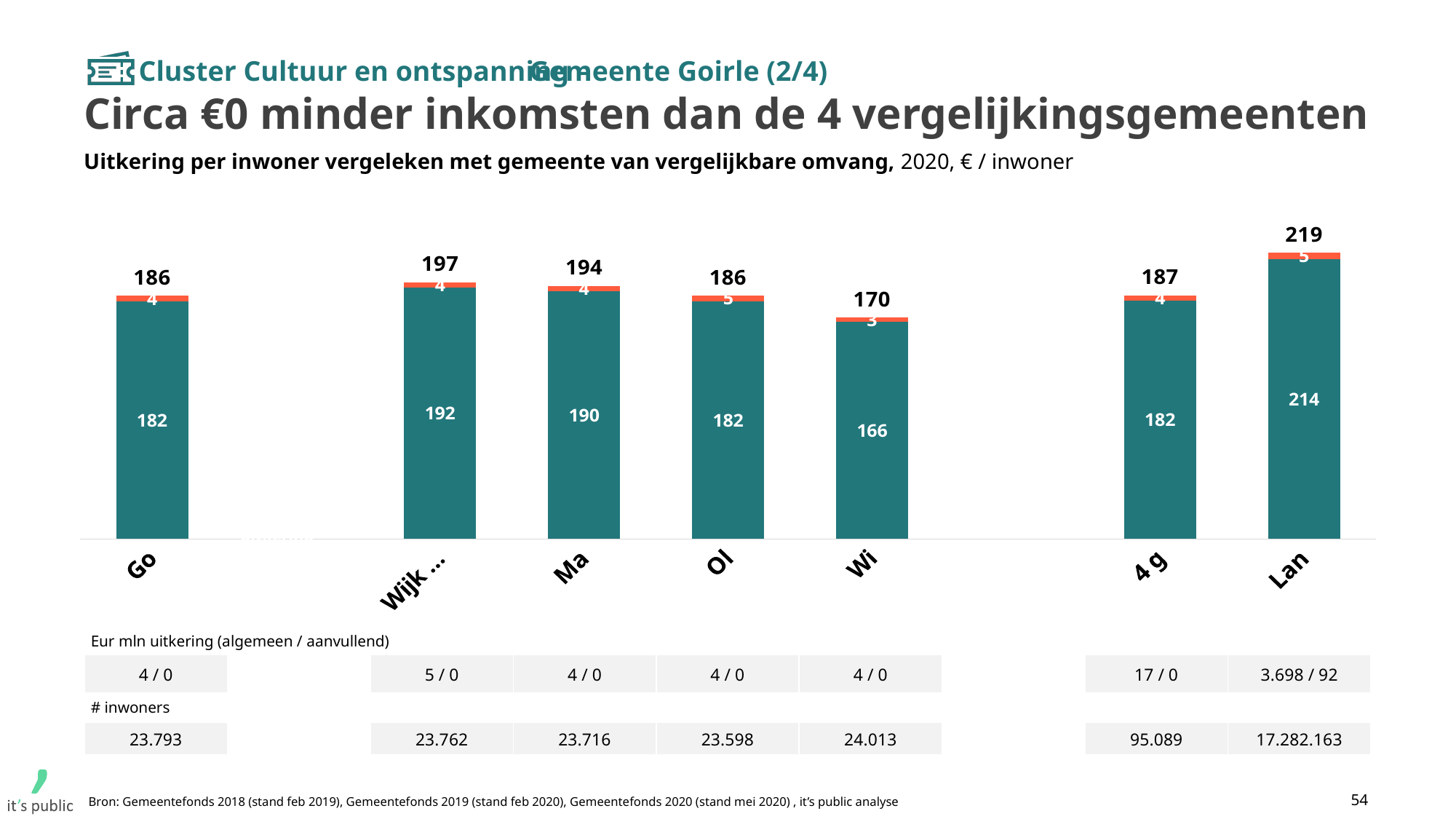
What is the sum of the two segments of the bar for 4 g? 186 What kind of chart is shown on the slide? Stacked bar chart What is the value of the small orange segment on top of the bar for Ol? 5 What is the difference between the total for Lan and the total for Wi? 49 What is the number of inhabitants (# inwoners) listed under the bar for Go? 23.793 What is the value of the large teal segment of the bar for Wi? 166 Which category has the lowest total value? Wi What is the total value shown above the bar for Lan? 219 Which category has the highest total value? Lan What is the total value shown above the bar for Go? 186 Which has a larger total, Wijk ... or Ma? Wijk ... How many bars with data labels are plotted in the chart? 7